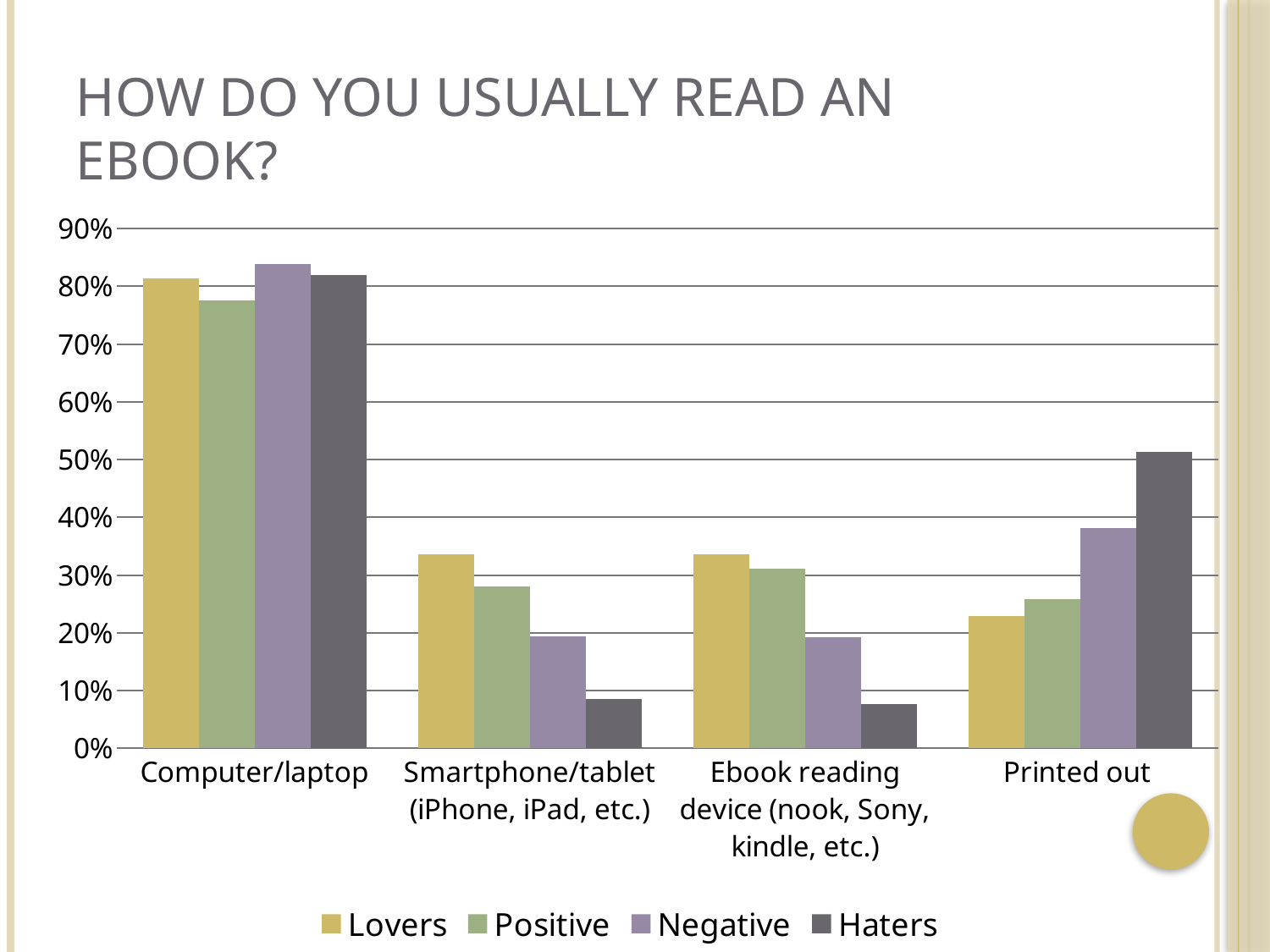
Is the Haters value for Printed out greater or less than 40%? greater How many reading-method categories are shown on the x axis? 4 For Printed out, which is larger: the Haters value or the Lovers value? Haters Which category has the highest value for the Haters series? Computer/laptop What is the title of the chart? How do you usually read an ebook? For Computer/laptop, which is larger: the Negative value or the Positive value? Negative What kind of chart is shown on the slide? bar chart Is the Lovers value for Computer/laptop greater or less than 70%? greater How many series does the legend list? 4 Is the Haters value for Smartphone/tablet (iPhone, iPad, etc.) greater or less than 10%? less Which category has the highest value for the Negative series? Computer/laptop Which category has the lowest value for the Lovers series? Printed out